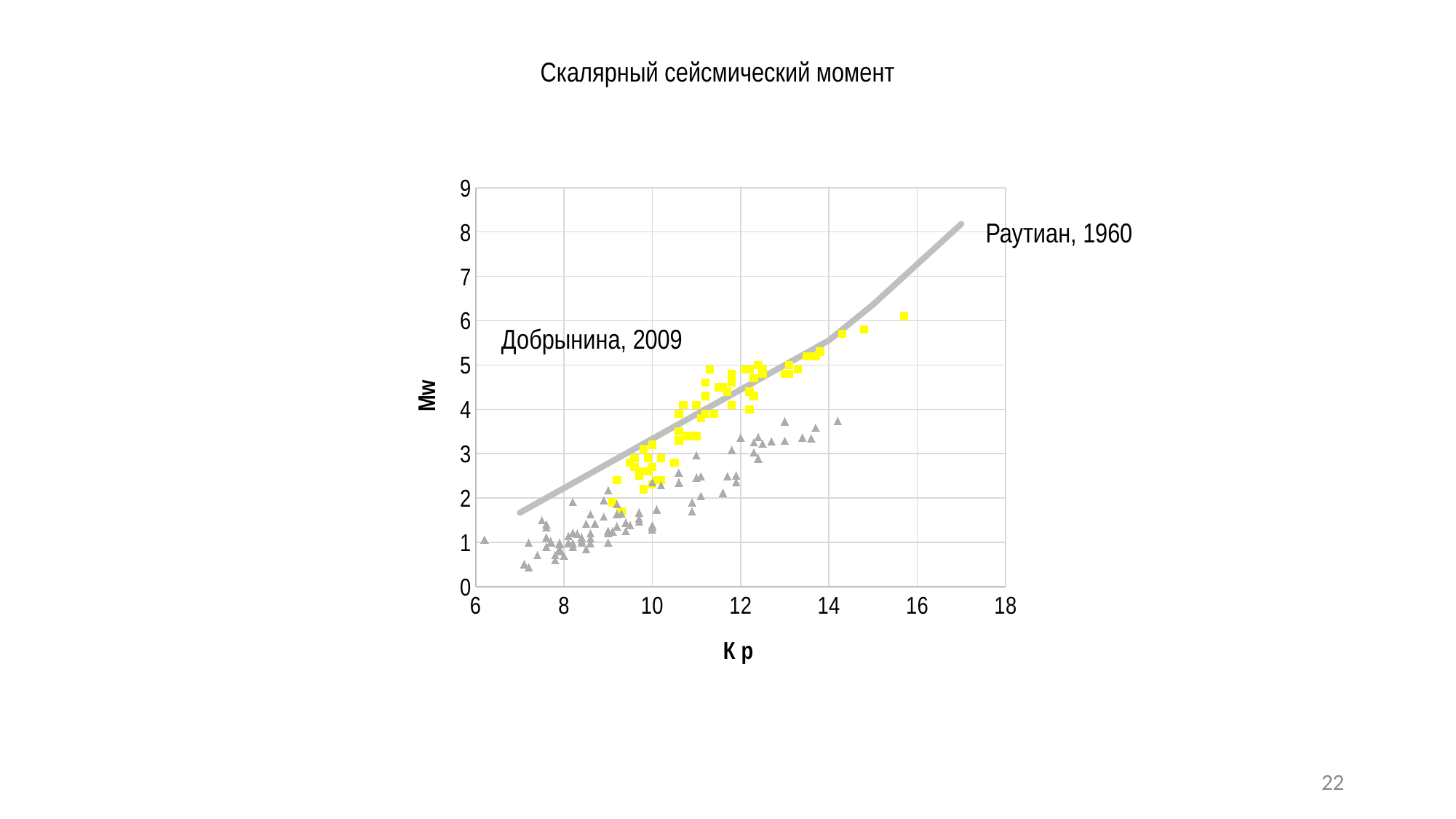
At K p = 12, are the yellow square points (Добрынина, 2009) higher or lower in Mw than the grey triangle points? higher What is the title of the chart? Скалярный сейсмический момент Is the value of the Раутиан, 1960 line at K p = 10 greater or less than 4? less Are all the grey triangle points below or above Mw = 4? below What is the maximum value shown on the K p axis? 18 Is the K p value of the rightmost yellow square point greater or less than 16? less Does the Раутиан, 1960 line rise or fall as K p increases? rise What kind of chart is shown on the slide? scatter chart What is the label of the vertical axis? Mw